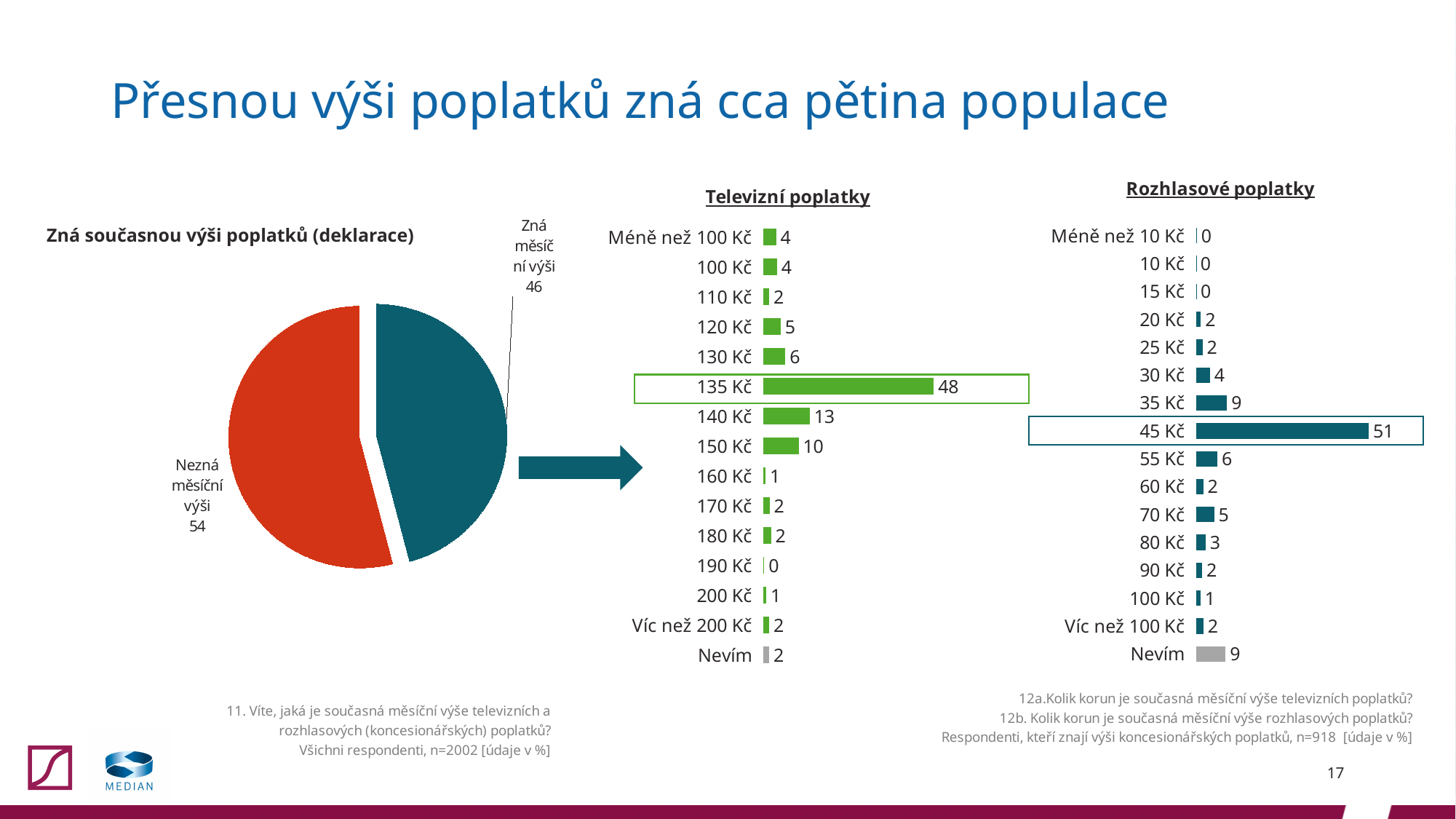
In the 'Rozhlasové poplatky' chart, what is the value for '45 Kč'? 51 In the pie chart 'Zná současnou výši poplatků (deklarace)', what is the value for 'Nezná měsíční výši'? 54 In the 'Televizní poplatky' chart, what is the value for 'Nevím'? 2 In the 'Televizní poplatky' chart, which category has the highest value? 135 Kč What kind of chart is the 'Televizní poplatky' chart? Bar chart In the 'Rozhlasové poplatky' chart, what is the value for '35 Kč'? 9 In the 'Rozhlasové poplatky' chart, which category has the highest value? 45 Kč In the pie chart 'Zná současnou výši poplatků (deklarace)', which slice is larger: 'Nezná měsíční výši' or 'Zná měsíční výši'? Nezná měsíční výši In the 'Televizní poplatky' chart, what is the value for '135 Kč'? 48 In the pie chart 'Zná současnou výši poplatků (deklarace)', what is the value for 'Zná měsíční výši'? 46 In the 'Rozhlasové poplatky' chart, which is larger: the value for '55 Kč' or the value for '70 Kč'? 55 Kč In the 'Televizní poplatky' chart, what is the difference between the values for '140 Kč' and '150 Kč'? 3